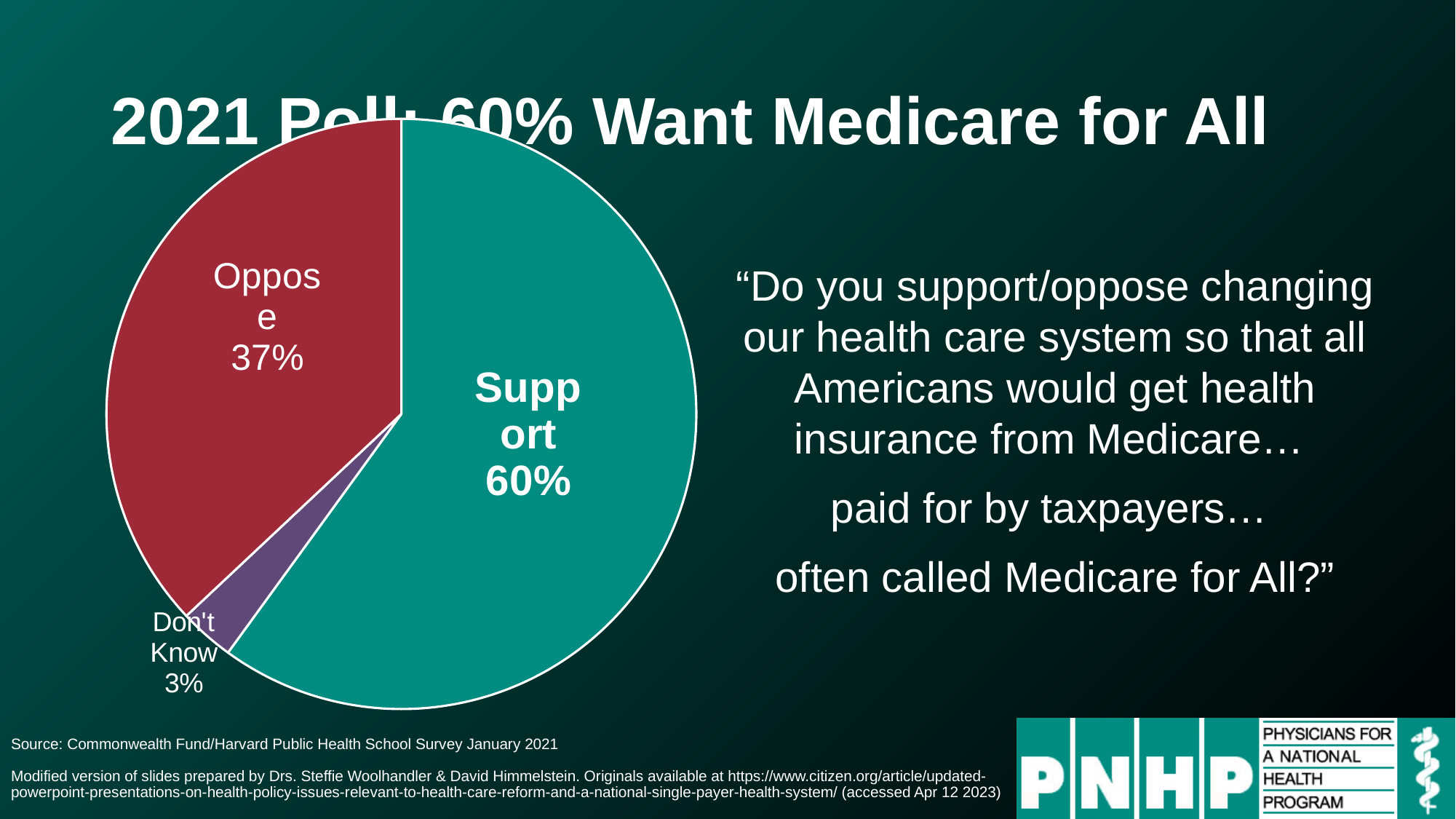
What is the difference in percentage points between Oppose and Don't Know? 34 Which is larger, the Support share or the Oppose share? Support Which response has the smallest share of the pie? Don't Know What colour is the Support slice of the pie? teal What percentage of respondents said they Oppose Medicare for All? 37% How many slices does the pie chart have? 3 Which response has the largest share of the pie? Support What colour is the Oppose slice of the pie? red What percentage of respondents answered Don't Know? 3% What is the difference in percentage points between Support and Oppose? 23 What kind of chart is shown on the slide? pie chart What percentage of respondents said they Support Medicare for All? 60%